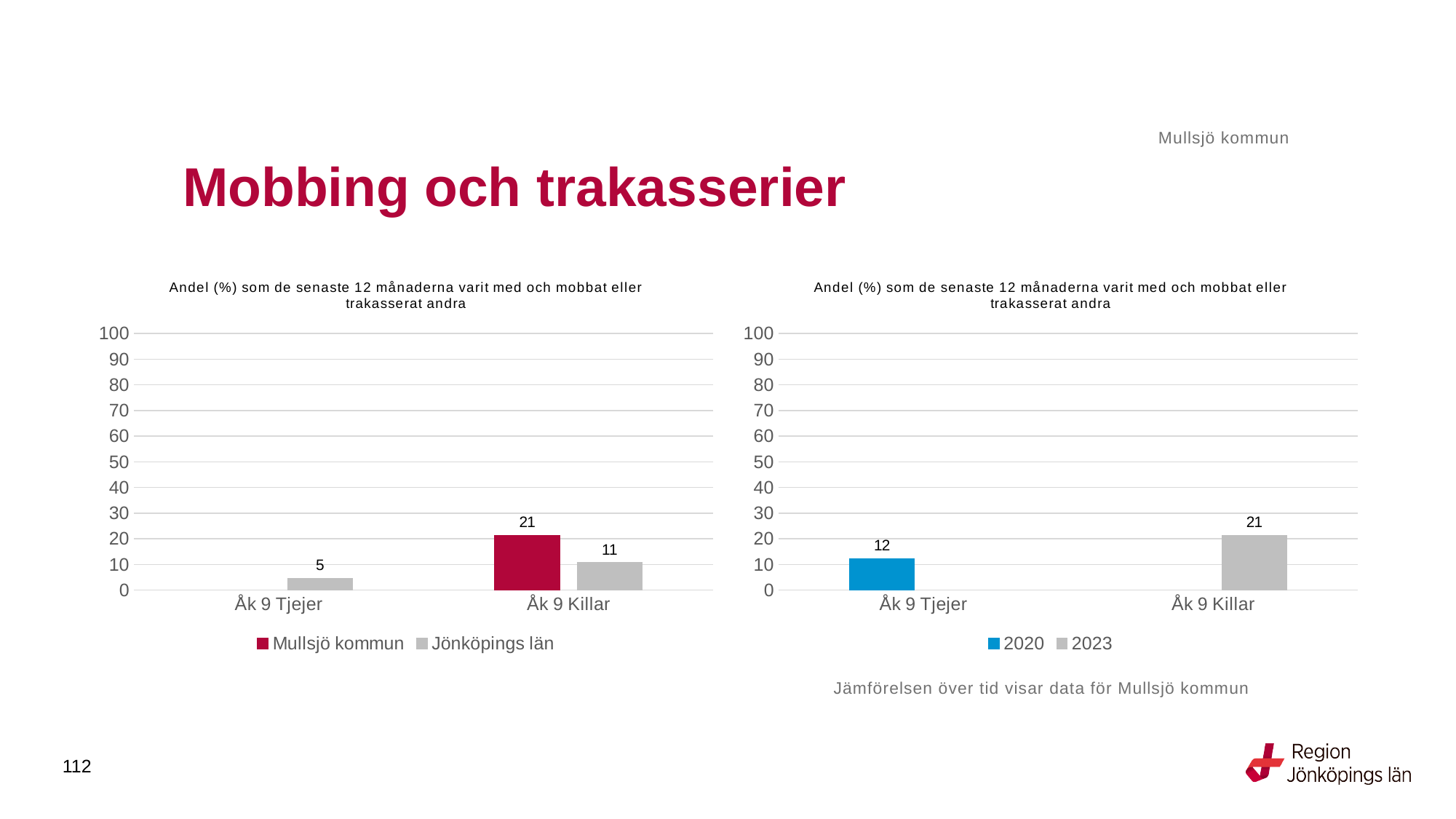
In the left chart, is the value for Mullsjö kommun for Åk 9 Killar greater or less than 30? less What kind of chart is the left chart? bar chart In the left chart, what is the value for Mullsjö kommun for Åk 9 Killar? 21 In the right chart, what is the value for 2020 for Åk 9 Tjejer? 12 How many series does the legend of the right chart list? 2 In the left chart, what is the value for Jönköpings län for Åk 9 Tjejer? 5 In the right chart, what is the value for 2023 for Åk 9 Killar? 21 In the left chart, what is the difference between Mullsjö kommun and Jönköpings län for Åk 9 Killar? 10 What are the two series listed in the legend of the left chart? Mullsjö kommun and Jönköpings län In the right chart, is the value for 2020 for Åk 9 Tjejer greater or less than 10? greater In the left chart, what is the value for Jönköpings län for Åk 9 Killar? 11 In the left chart, which is larger for Åk 9 Killar: Mullsjö kommun or Jönköpings län? Mullsjö kommun